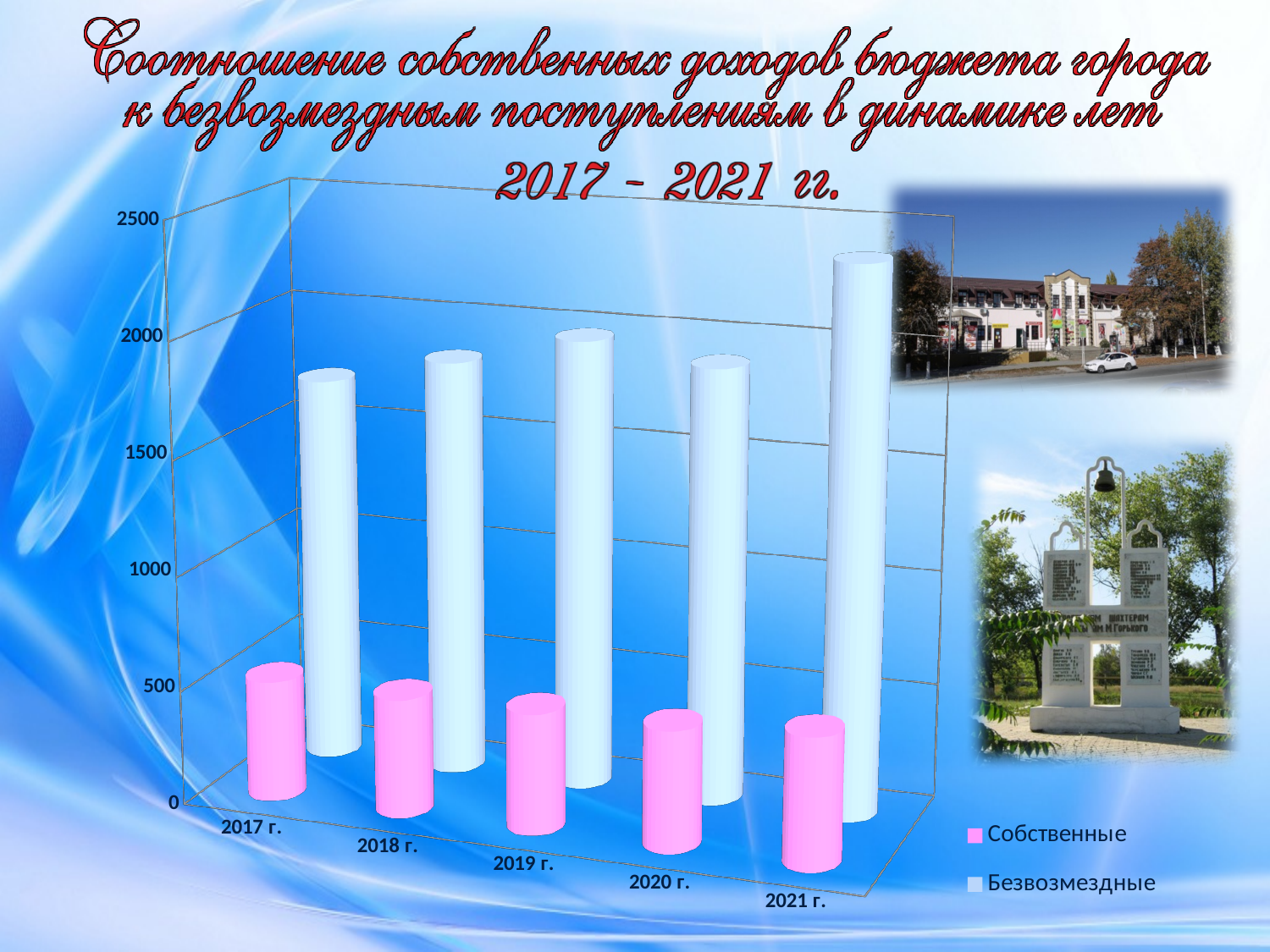
Is the value for Собственные in 2021 г. greater or less than 1000? less What kind of chart is shown on the slide? bar chart Which year has the lowest value for Безвозмездные? 2017 г. In 2021 г., which is larger: Собственные or Безвозмездные? Безвозмездные Which year has the highest value for Безвозмездные? 2021 г. How many years are shown on the x axis of the chart? 5 Is the value for Безвозмездные in 2017 г. greater or less than 1500? greater How many series does the chart legend list? 2 Is the value for Собственные in 2017 г. greater or less than 1000? less What range of years does the chart title say the data covers? 2017 - 2021 гг. Which colour represents the Собственные series in the chart? pink